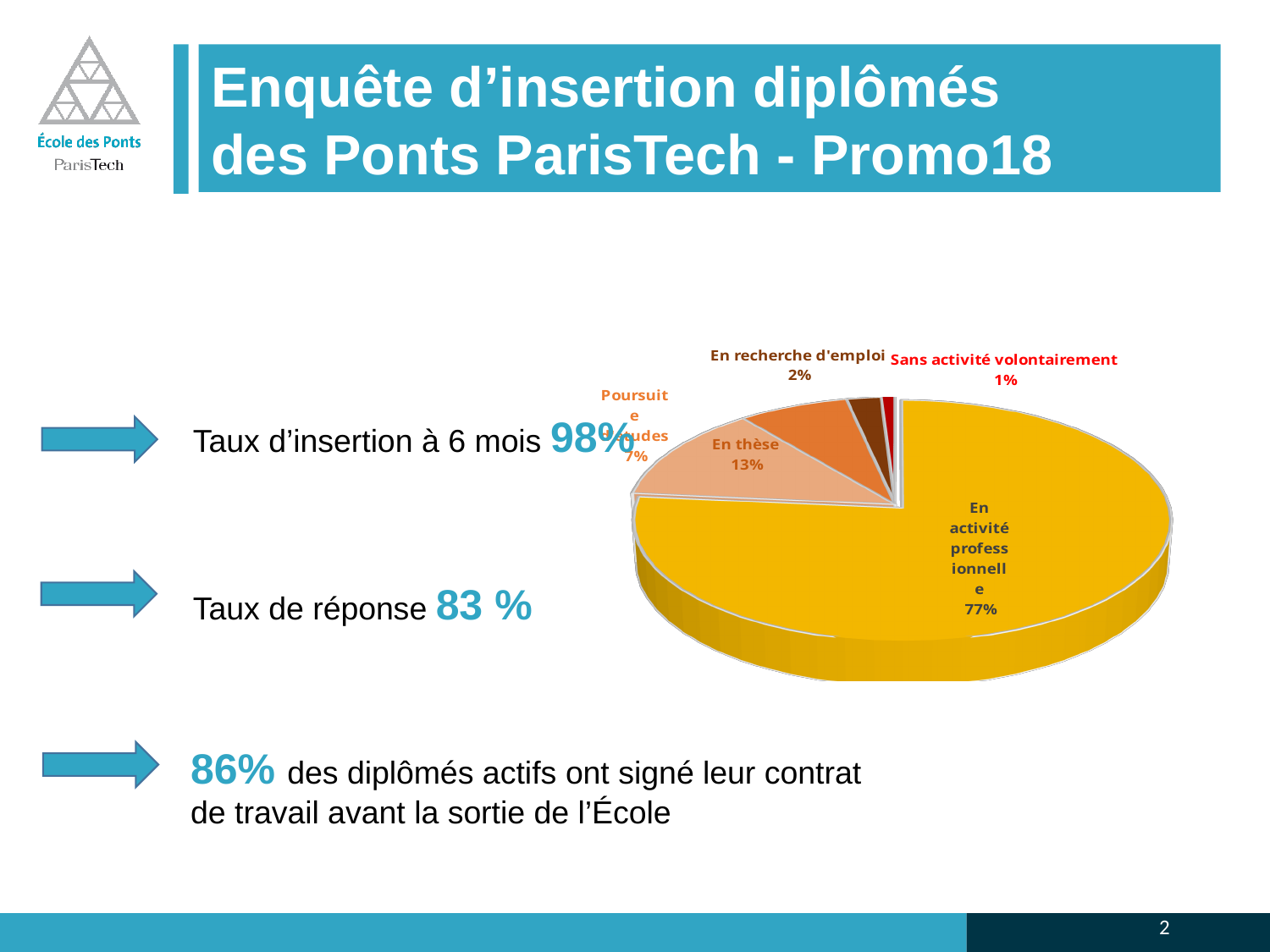
What percentage is shown for "En recherche d'emploi"? 2% What is the difference in percentage points between "En activité professionnelle" and "En thèse"? 64 What percentage is shown for "Poursuite d'études"? 7% What share of the pie is labelled "En activité professionnelle"? 77% What percentage is shown for "En thèse"? 13% Which category has the largest slice of the pie? En activité professionnelle Which category has the smallest slice of the pie? Sans activité volontairement How many slices does the pie chart have? 5 Which is larger, the share for "En thèse" or the share for "En recherche d'emploi"? En thèse What colour is the "En activité professionnelle" slice? yellow What percentage is shown for "Sans activité volontairement"? 1% What kind of chart is shown on the slide? pie chart